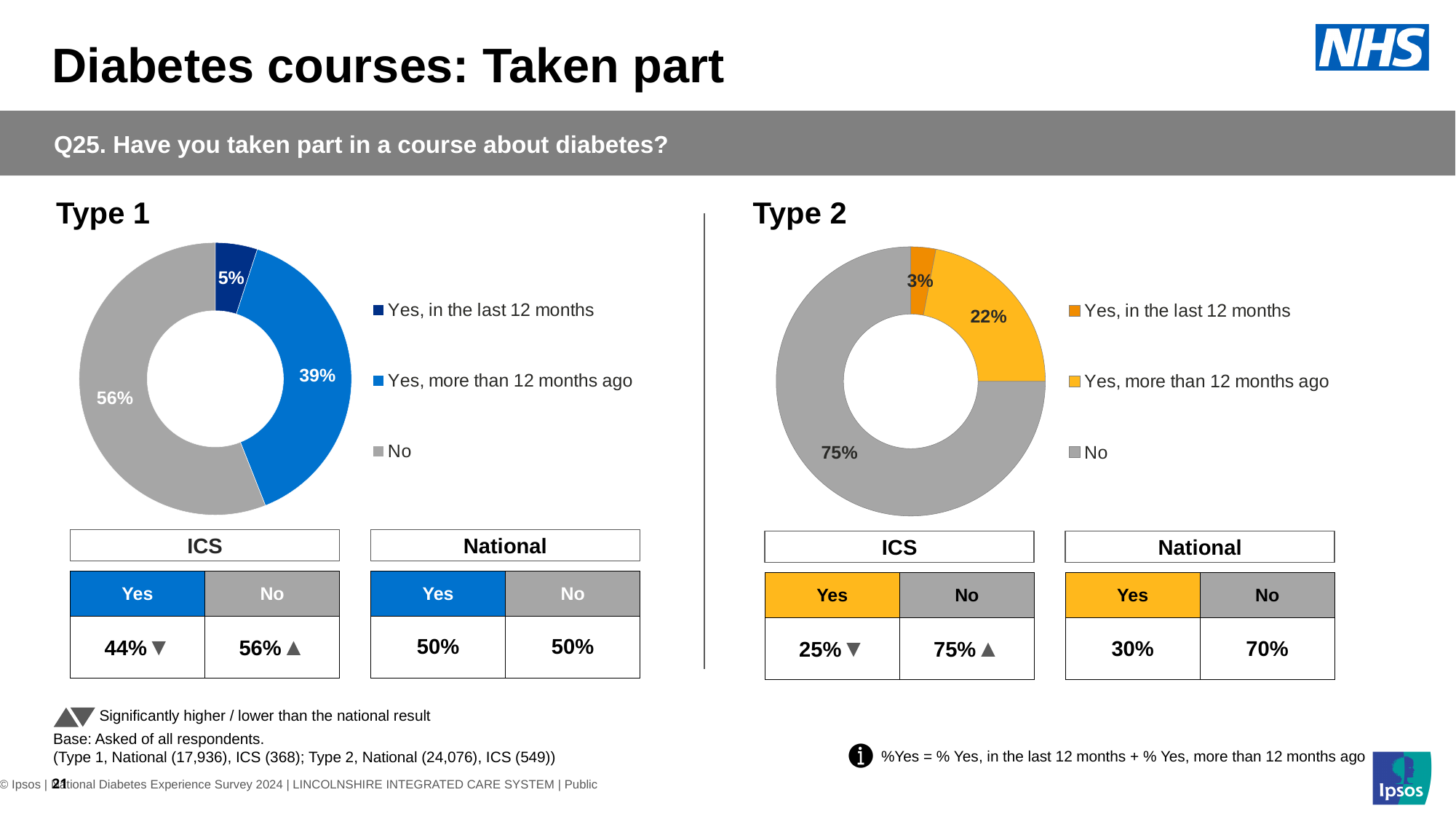
How many categories does the Type 2 chart show? 3 In the Type 1 chart, what is the difference between the 'No' share and the 'Yes, more than 12 months ago' share? 17% In the Type 2 chart, which category has the largest share? No In the Type 1 chart, what percentage answered 'Yes, in the last 12 months'? 5% How many legend entries does the Type 2 chart list? 3 In the Type 2 chart, what is the combined share of the two 'Yes' categories? 25% In the Type 1 chart, what percentage of respondents answered 'No'? 56% Which is larger: the 'Yes, more than 12 months ago' share in the Type 1 chart or in the Type 2 chart? Type 1 In the Type 1 chart, which category has the smallest share? Yes, in the last 12 months What kind of chart is used for Type 1? Doughnut chart In the Type 1 chart, what colour represents 'No'? Grey In the Type 2 chart, what percentage of respondents answered 'Yes, more than 12 months ago'? 22%